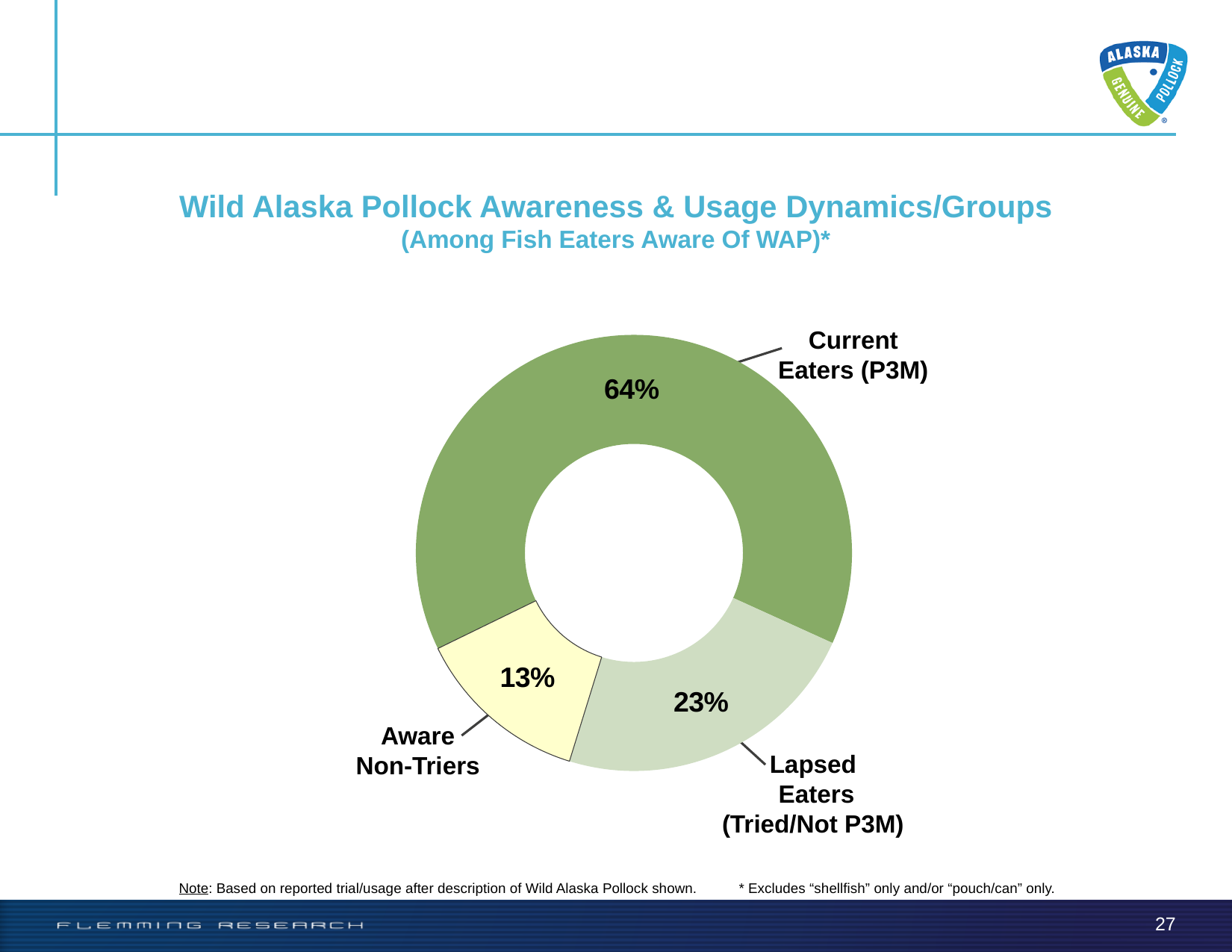
Which group has the largest share of the chart? Current Eaters (P3M) What kind of chart is shown on the slide? Pie chart (doughnut) What share of fish eaters aware of WAP are Aware Non-Triers? 13% What share of fish eaters aware of WAP are Current Eaters (P3M)? 64% How many groups are shown in the chart? 3 Which group has a larger share: Lapsed Eaters (Tried/Not P3M) or Aware Non-Triers? Lapsed Eaters (Tried/Not P3M) What is the difference in percentage points between Lapsed Eaters (Tried/Not P3M) and Aware Non-Triers? 10 percentage points What is the title of the chart? Wild Alaska Pollock Awareness & Usage Dynamics/Groups (Among Fish Eaters Aware Of WAP)* What is the combined share of Lapsed Eaters (Tried/Not P3M) and Aware Non-Triers? 36% What share of fish eaters aware of WAP are Lapsed Eaters (Tried/Not P3M)? 23% Which group has the smallest share of the chart? Aware Non-Triers What is the difference in percentage points between Current Eaters (P3M) and Lapsed Eaters (Tried/Not P3M)? 41 percentage points